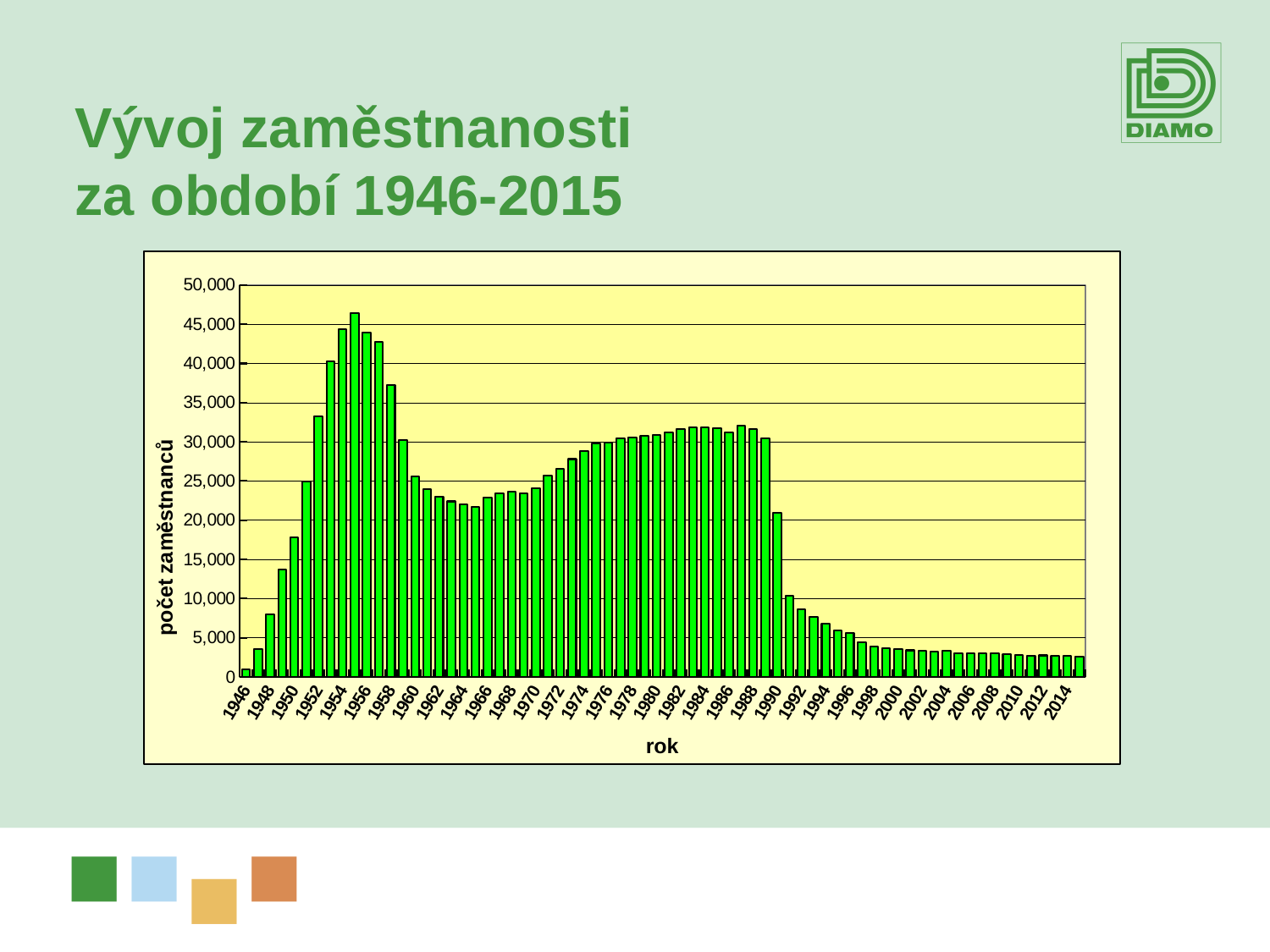
Is the value for 1966 greater or less than 25,000? less Which year has the larger value, 1990 or 1992? 1990 Is the value for 2014 greater or less than 5,000? less Which year has the larger value, 1955 or 1985? 1955 Is the value for 1955 greater or less than 40,000? greater Do the values rise or fall from 1990 to 2014? fall Which year has the lowest number of employees? 1946 What kind of chart is shown on the slide? bar chart What is the label of the vertical axis? počet zaměstnanců Which year has the highest number of employees? 1955